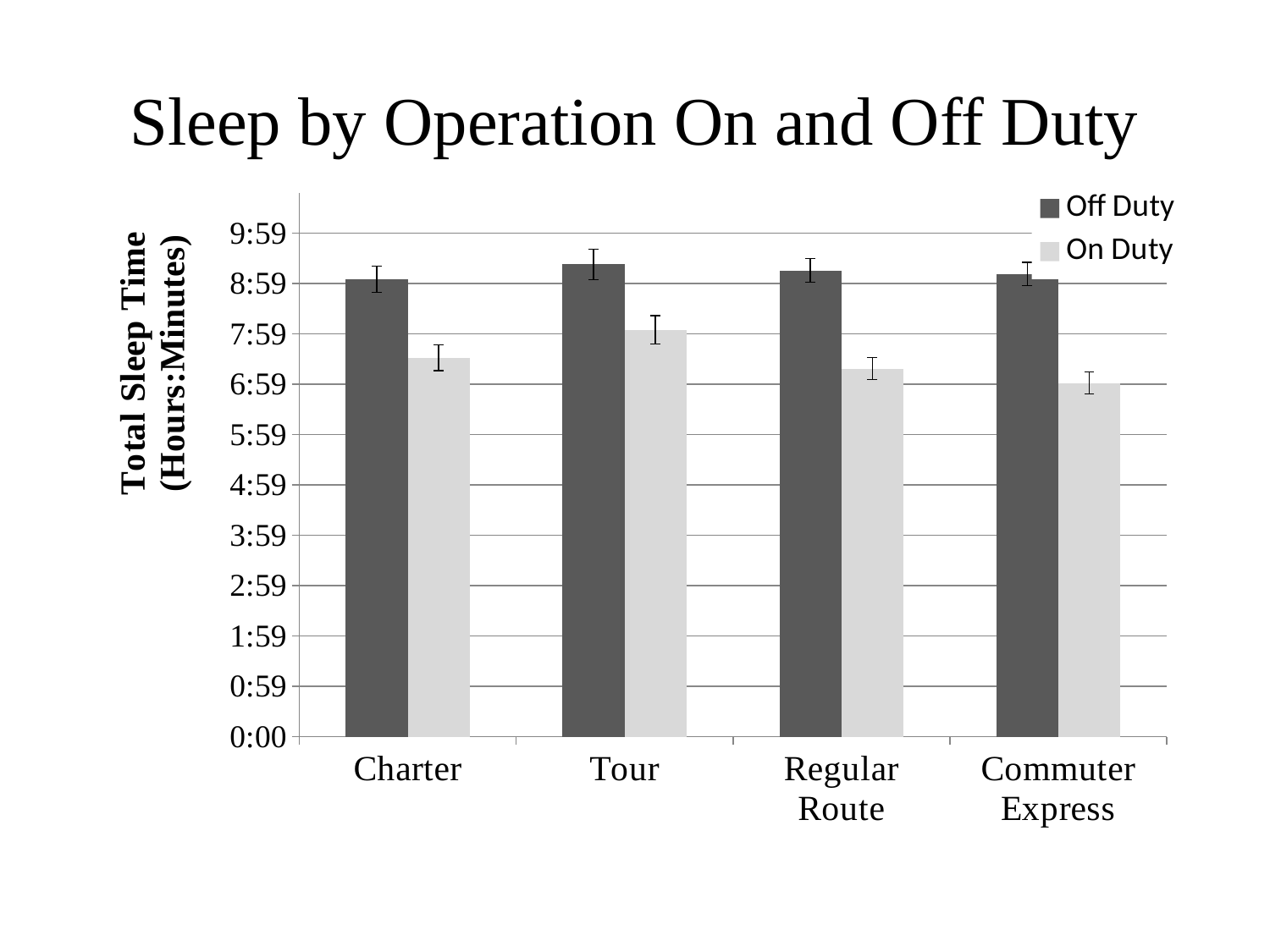
How many operation categories are shown on the x axis? 4 What kind of chart is shown on the slide? bar chart Which is larger: the On Duty value for Tour or the On Duty value for Regular Route? Tour How many series does the legend list? 2 What are the two series named in the legend? Off Duty and On Duty What is the title of the chart? Sleep by Operation On and Off Duty Is the Off Duty value for Commuter Express greater or less than 9:59? less For Charter, which is larger: the Off Duty value or the On Duty value? Off Duty Is the On Duty value for Charter greater or less than 6:59? greater Which operation has the highest On Duty sleep time? Tour Is the On Duty value for Commuter Express greater or less than 7:59? less